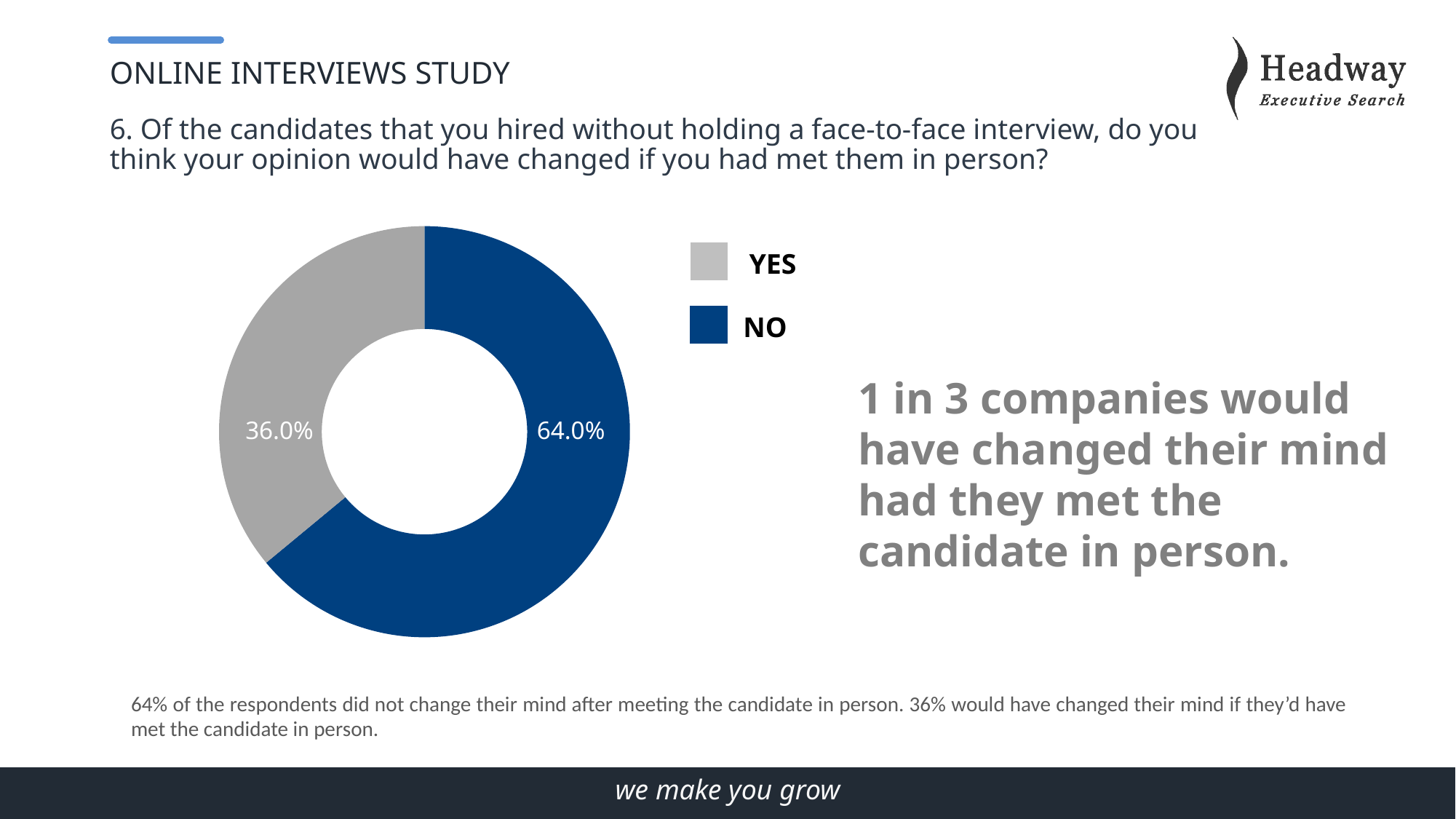
What percentage of respondents answered NO? 64.0% What kind of chart is shown on the slide? Pie chart (doughnut) What colour is the NO slice in the chart? Dark blue Which response has the largest share of the chart? NO How many entries does the legend list? 2 How many categories are shown in the chart? 2 What percentage of respondents answered YES? 36.0% What share of the chart does the NO slice represent? 64.0% Which is larger, the YES share or the NO share? NO What colour is the YES slice in the chart? Grey What is the difference in percentage points between the NO and YES shares? 28.0% Which response has the smallest share of the chart? YES